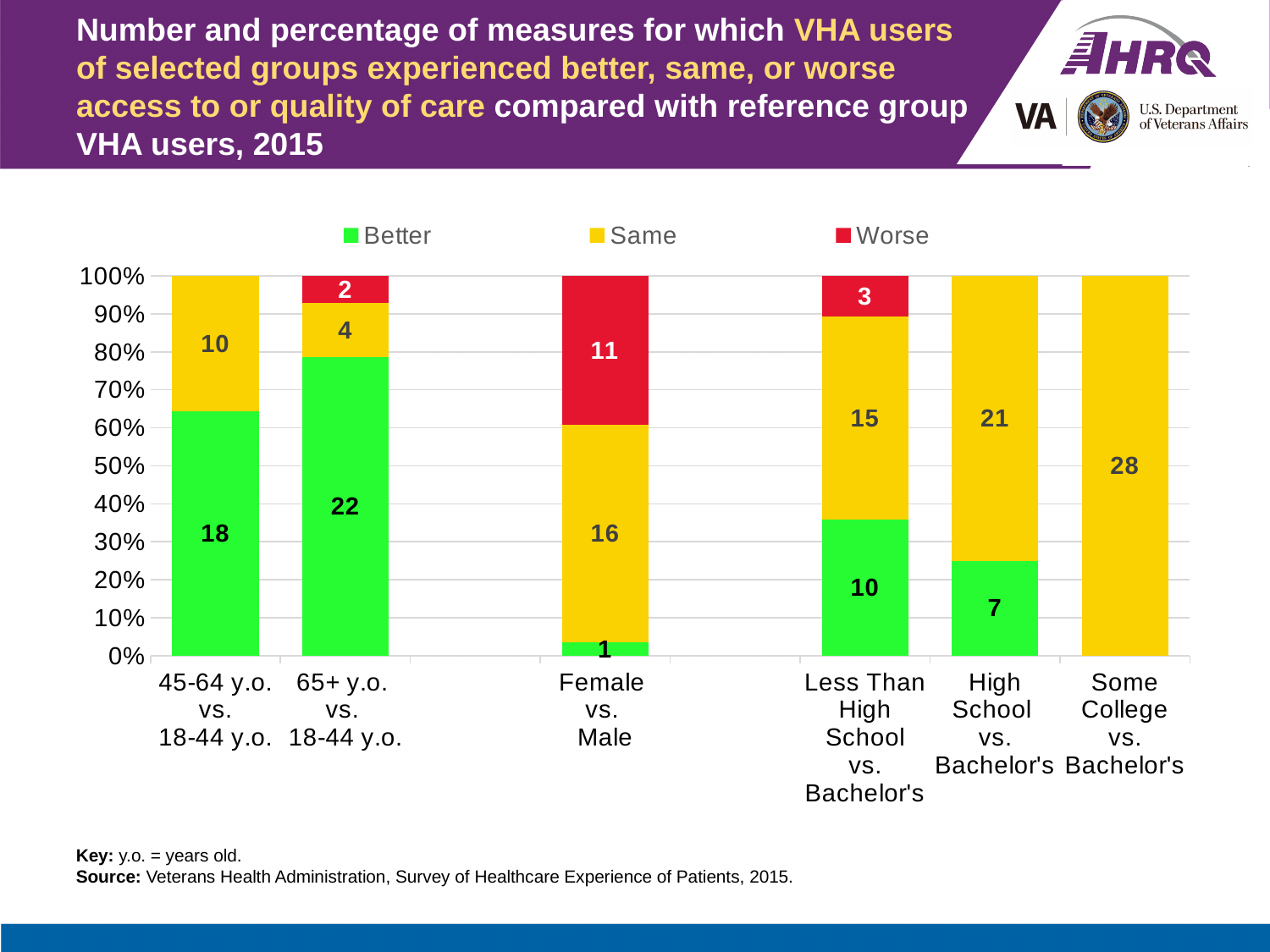
Which group has the highest number of 'Better' measures? 65+ y.o. vs. 18-44 y.o. How many measures were 'Worse' for Less Than High School vs. Bachelor's? 3 What is the difference between the 'Same' count for Some College vs. Bachelor's and the 'Same' count for Female vs. Male? 12 How many comparison groups are shown on the x axis? 6 How many measures were 'Same' for High School vs. Bachelor's? 21 Which has more 'Better' measures: Less Than High School vs. Bachelor's or High School vs. Bachelor's? Less Than High School vs. Bachelor's How many measures were 'Worse' for Female vs. Male? 11 What kind of chart is shown on the slide? Stacked bar chart Which group has the lowest number of 'Same' measures? 65+ y.o. vs. 18-44 y.o. How many series does the legend list? 3 How many measures were 'Better' for 45-64 y.o. vs. 18-44 y.o.? 18 What is the total number of measures for the 65+ y.o. vs. 18-44 y.o. bar? 28